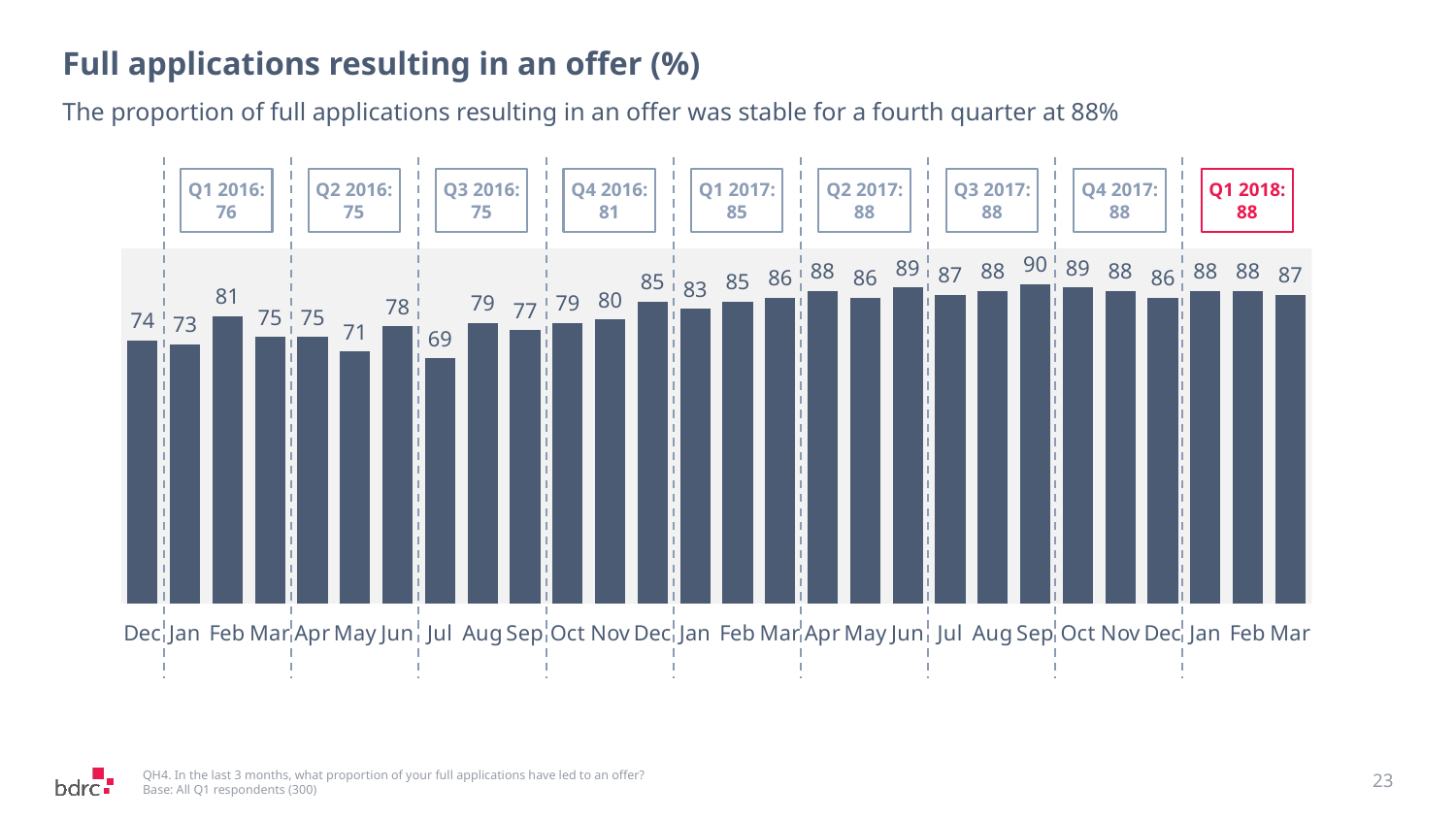
How many monthly bars are plotted on the chart? 28 Which month has the highest bar, and what is its value? Sep (Q3 2017), 90 What kind of chart is shown on the slide? bar chart By how much does the Q1 2017 quarterly value exceed the Q1 2016 quarterly value? 9 What is the quarterly value shown in the Q1 2018 box? 88 Which quarter box is highlighted in red? Q1 2018 Do the monthly values generally rise or fall from Dec 2015 to Mar 2018? rise Which is larger, the Feb bar in Q1 2016 or the May bar in Q2 2016? Feb (Q1 2016) Which month has the lowest bar, and what is its value? Jul (Q3 2016), 69 What is the quarterly value shown in the Q4 2016 box? 81 What is the value for the Mar bar in Q1 2018 (the last bar)? 87 What is the difference between the highest monthly value (Sep 2017) and the lowest monthly value (Jul 2016)? 21